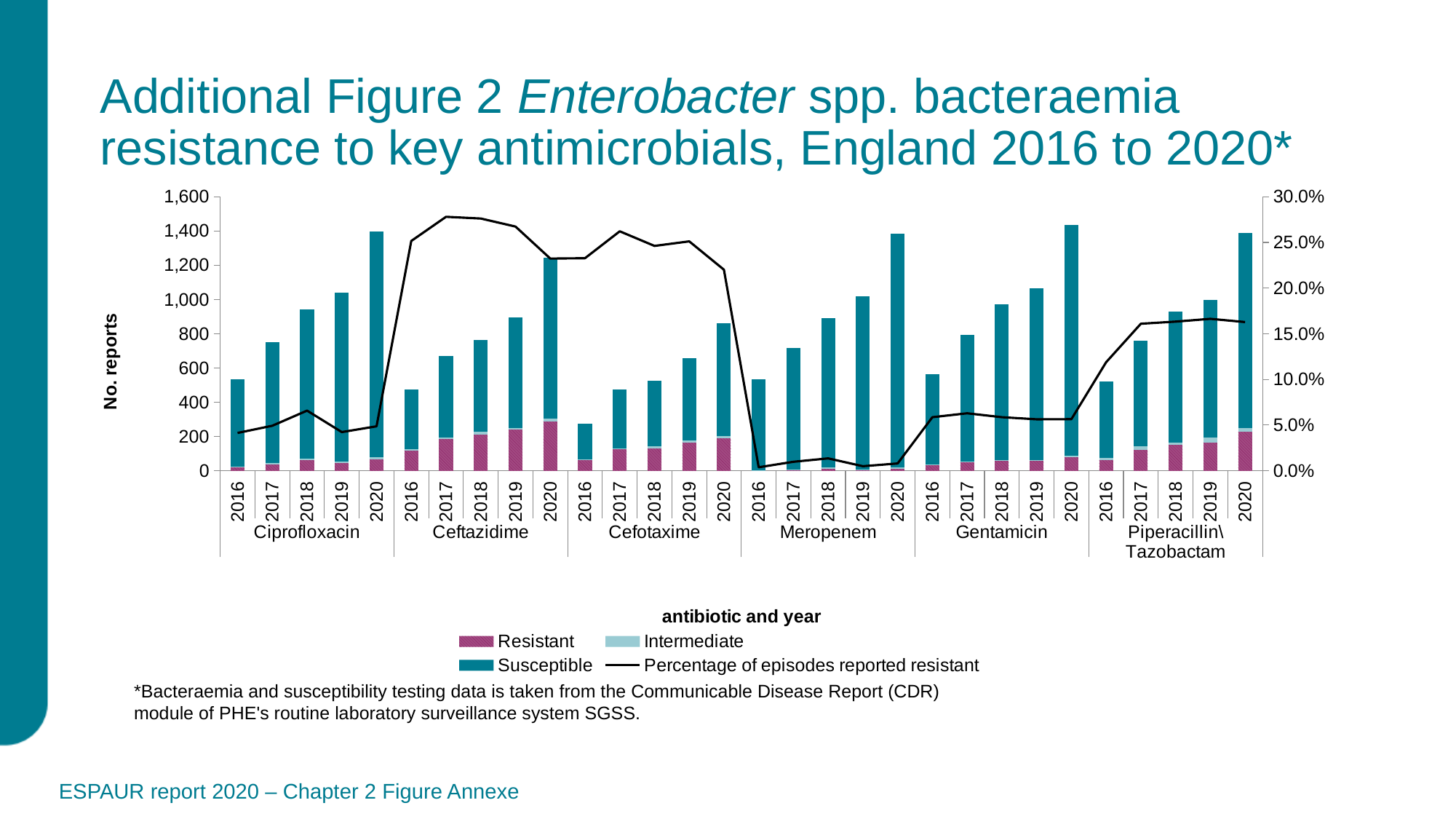
How many antibiotics are shown along the x axis? 6 Is the total number of reports for Ciprofloxacin in 2020 greater or less than 1,200? greater Do the total numbers of reports for Gentamicin rise or fall from 2016 to 2020? rise What kind of chart is shown on the slide? A stacked bar chart combined with a line chart Is the percentage of episodes reported resistant for Meropenem in 2016 greater or less than 5.0%? less Is the total number of reports for Cefotaxime in 2016 greater or less than 400? less Within Meropenem, which year has the lowest total number of reports? 2016 How many bars are plotted in total across all antibiotics? 30 Within Ciprofloxacin, which year has the highest total number of reports? 2020 Which has the higher percentage of episodes reported resistant in 2017: Cefotaxime or Gentamicin? Cefotaxime How many series does the legend list? 4